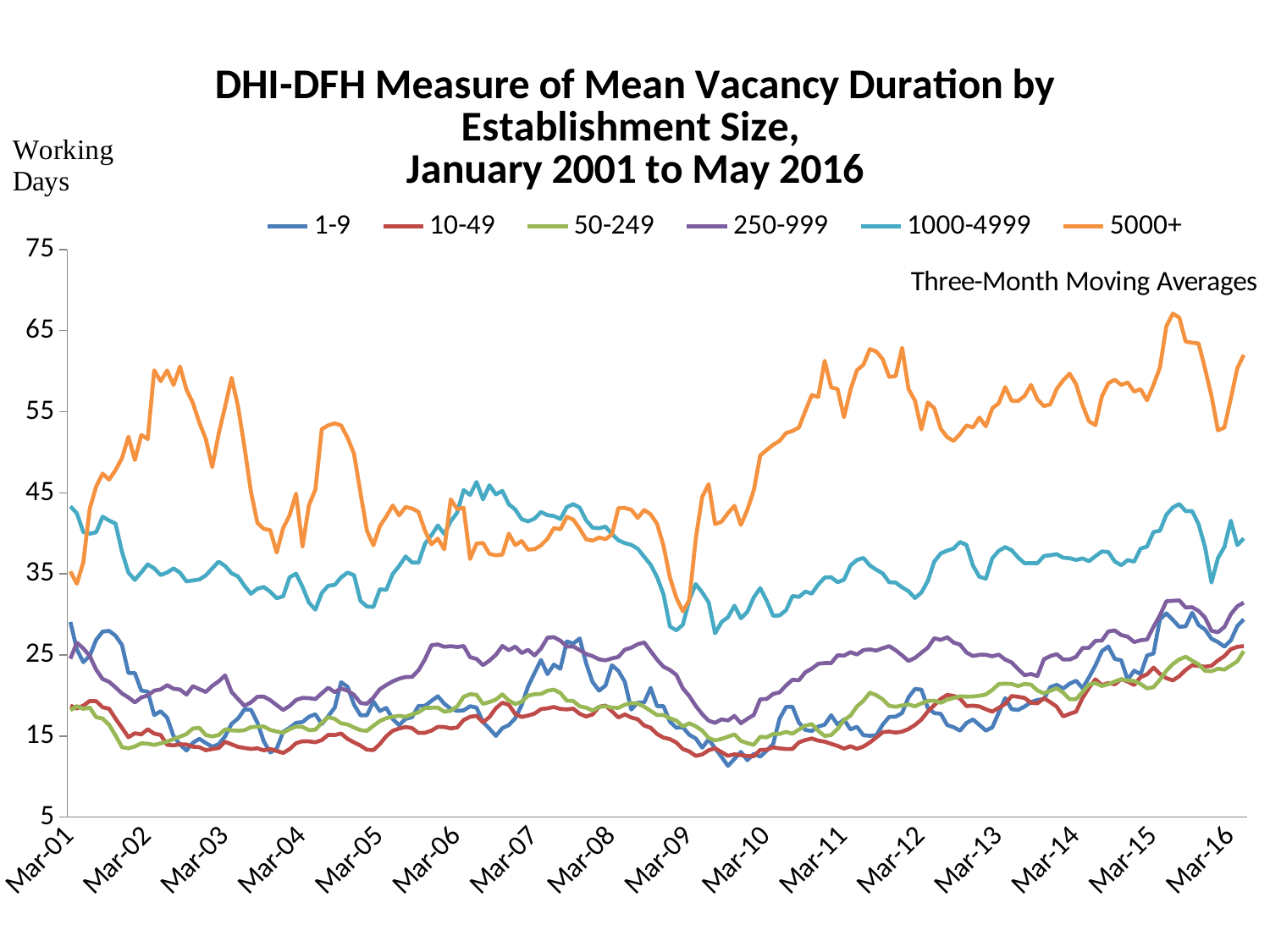
What kind of chart is shown on the slide? line chart At Mar-16, which series has the larger value: 1000-4999 or 250-999? 1000-4999 At Mar-11, which series has the larger value: 5000+ or 1000-4999? 5000+ Is the value for the 1000-4999 series at Mar-09 greater or less than 35? less Is the value for the 5000+ series at Mar-01 greater or less than 45? less What unit is shown on the vertical axis label? Working Days Which establishment size series has the highest vacancy duration values across the chart? 5000+ Does the 5000+ series rise or fall between Mar-09 and Mar-11? rise Is the peak value of the 5000+ series around Mar-15 greater or less than 55? greater How many series does the legend list? 6 Does the 1000-4999 series rise or fall between Mar-01 and Mar-04? fall